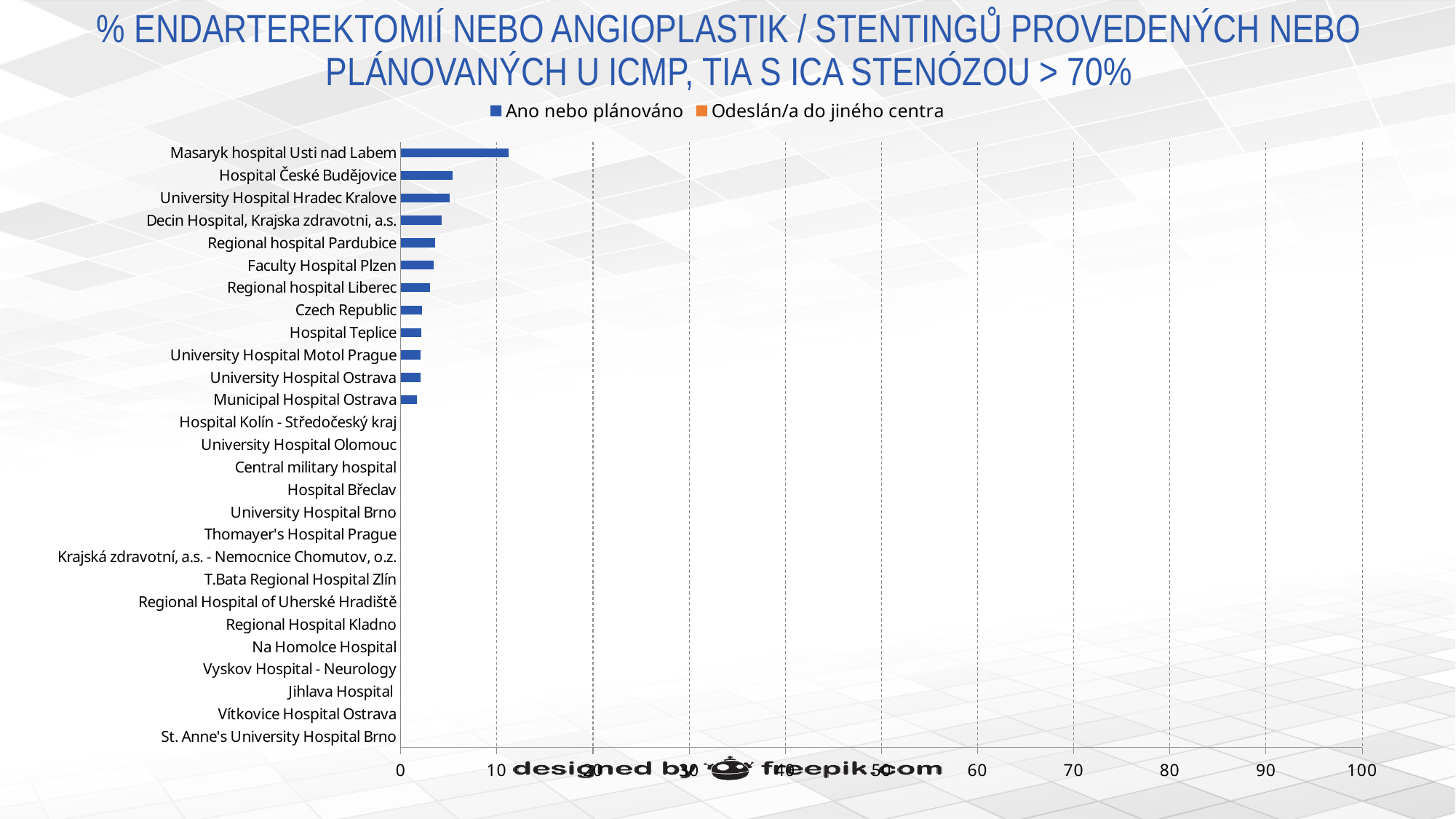
Is the value for Hospital České Budějovice greater or less than 10? less What kind of chart is shown on the slide? bar chart Which is larger, the value for University Hospital Hradec Kralove or the value for Municipal Hospital Ostrava? University Hospital Hradec Kralove Which is larger, the value for Masaryk hospital Usti nad Labem or the value for Hospital České Budějovice? Masaryk hospital Usti nad Labem Is the value for Masaryk hospital Usti nad Labem greater or less than 20? less How many hospitals/categories are listed on the vertical axis? 27 Is the value for Czech Republic greater or less than 10? less Which category has the highest value for 'Ano nebo plánováno'? Masaryk hospital Usti nad Labem What is the highest value shown on the horizontal axis? 100 How many series does the legend list? 2 Do the bar values rise or fall going down the list from Masaryk hospital Usti nad Labem to St. Anne's University Hospital Brno? fall What are the two series named in the legend? Ano nebo plánováno; Odeslán/a do jiného centra